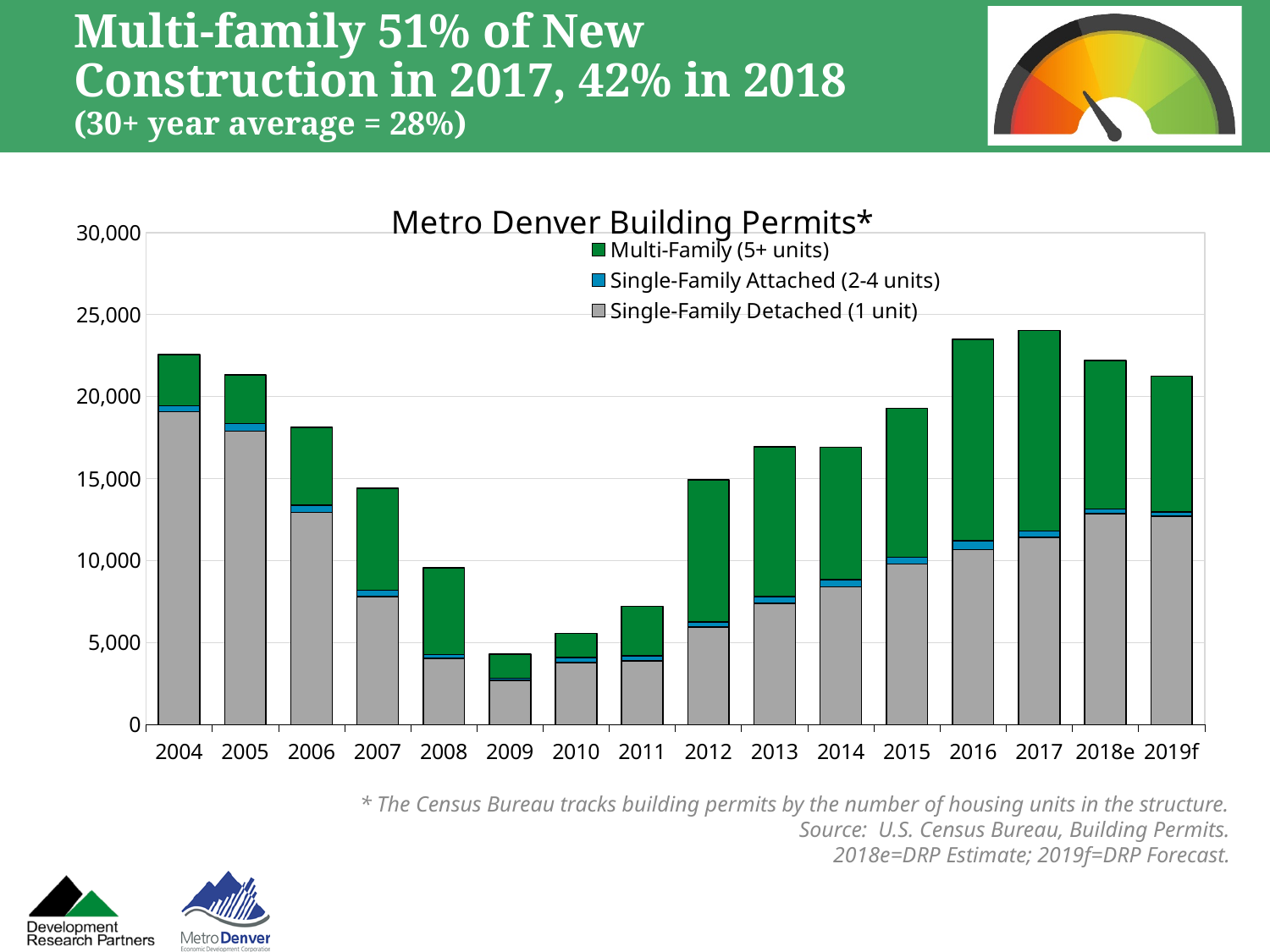
How many series does the chart's legend list? 3 What kind of chart is shown on the slide? Stacked bar chart Is the total bar for 2013 greater or less than 15,000? greater Which has the larger total bar, 2018e or 2019f? 2018e Is the total bar for 2004 greater or less than 20,000? greater Is the total bar for 2009 greater or less than 5,000? less Do the total building permits rise or fall from 2004 to 2009? Fall Which colour represents Multi-Family (5+ units) in the chart? Green Which year has the larger total bar, 2010 or 2011? 2011 How many years (categories) are shown on the x axis of the chart? 16 Which year has the lowest total building permits in the chart? 2009 What is the title of the chart? Metro Denver Building Permits*